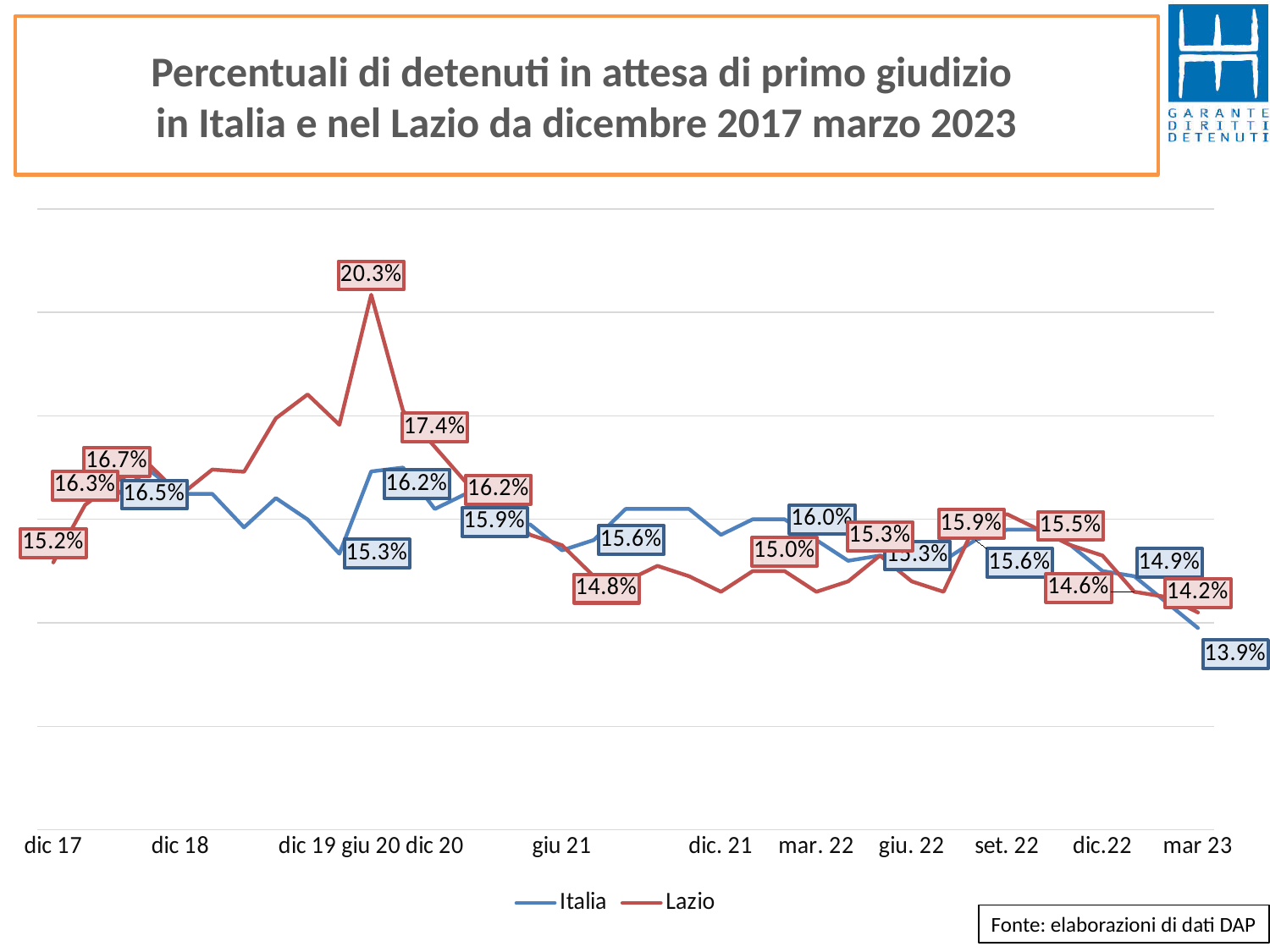
How many labels are shown on the x axis? 12 What kind of chart is shown on the slide? line chart What is the difference between the Lazio and Italia values at mar 23? 0.3 percentage points How many series does the legend list? 2 What is the value for Lazio at mar 23? 14.2% What is the value for Italia at mar 23? 13.9% Which series reaches the highest value on the chart? Lazio What is the lowest value of the Italia series? 13.9% At mar 23, which series has the larger value, Italia or Lazio? Lazio What is the highest value reached by the Lazio series? 20.3% Which two series are listed in the legend? Italia and Lazio